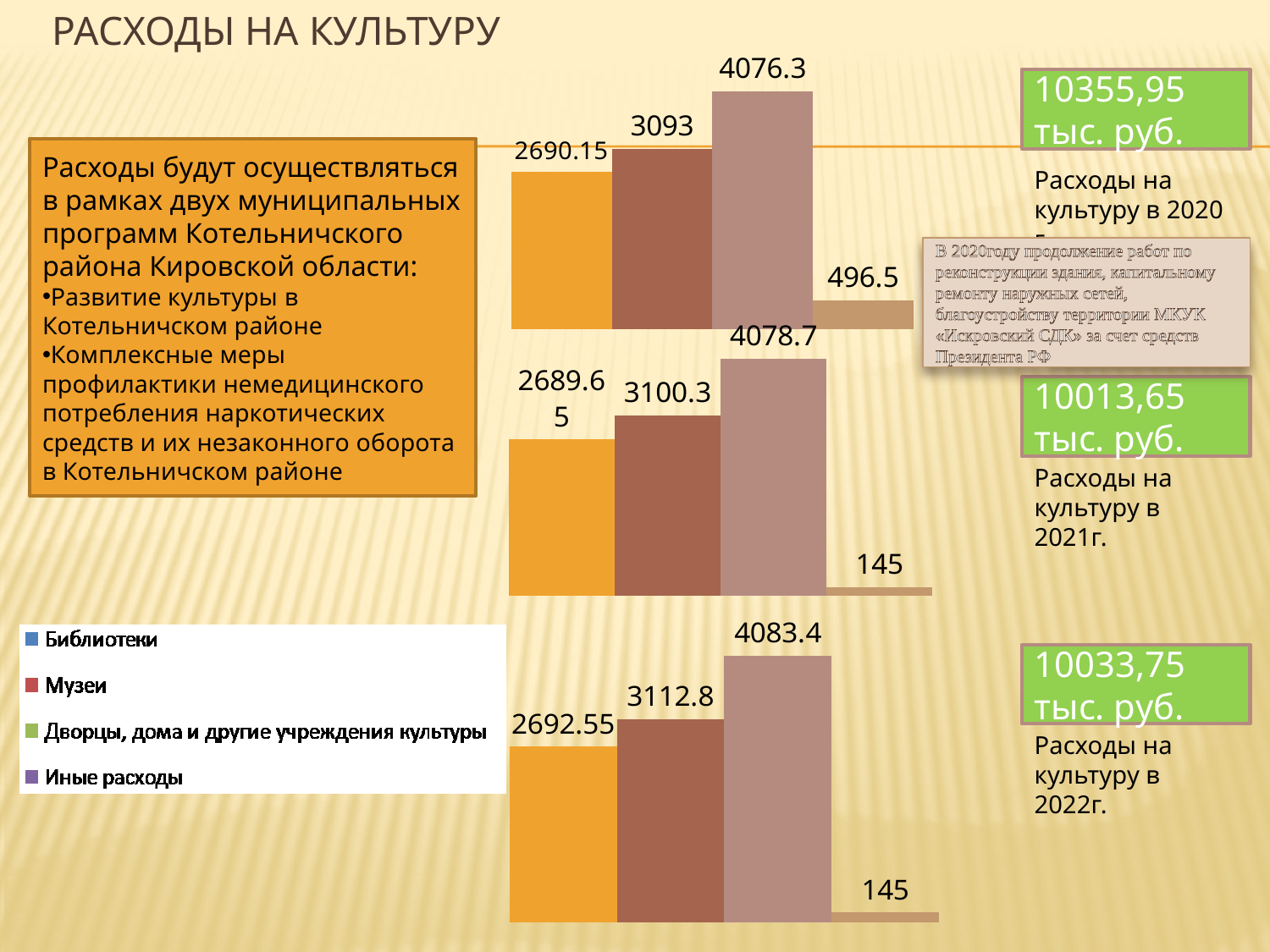
On the middle chart (2021), what is the value of the smallest bar? 145 On the top chart (2020), what is the difference between the tallest bar (4076.3) and the second bar (3093)? 983.3 On the top chart (2020), what is the highest value shown? 4076.3 What type of chart is used for the 2021 data? Bar chart On the middle chart (2021), what is the value of the second bar from the left? 3100.3 On the top chart (2020), what is the lowest value shown? 496.5 How many entries does the legend on the slide list? 4 How many bars does the top chart (2020) contain? 4 What is the third entry in the legend? Дворцы, дома и другие учреждения культуры On the middle chart (2021), which is larger: the first bar (2689.65) or the second bar (3100.3)? 3100.3 On the bottom chart (2022), what is the value of the tallest bar? 4083.4 On the bottom chart (2022), what is the difference between the second bar (3112.8) and the first bar (2692.55)? 420.25